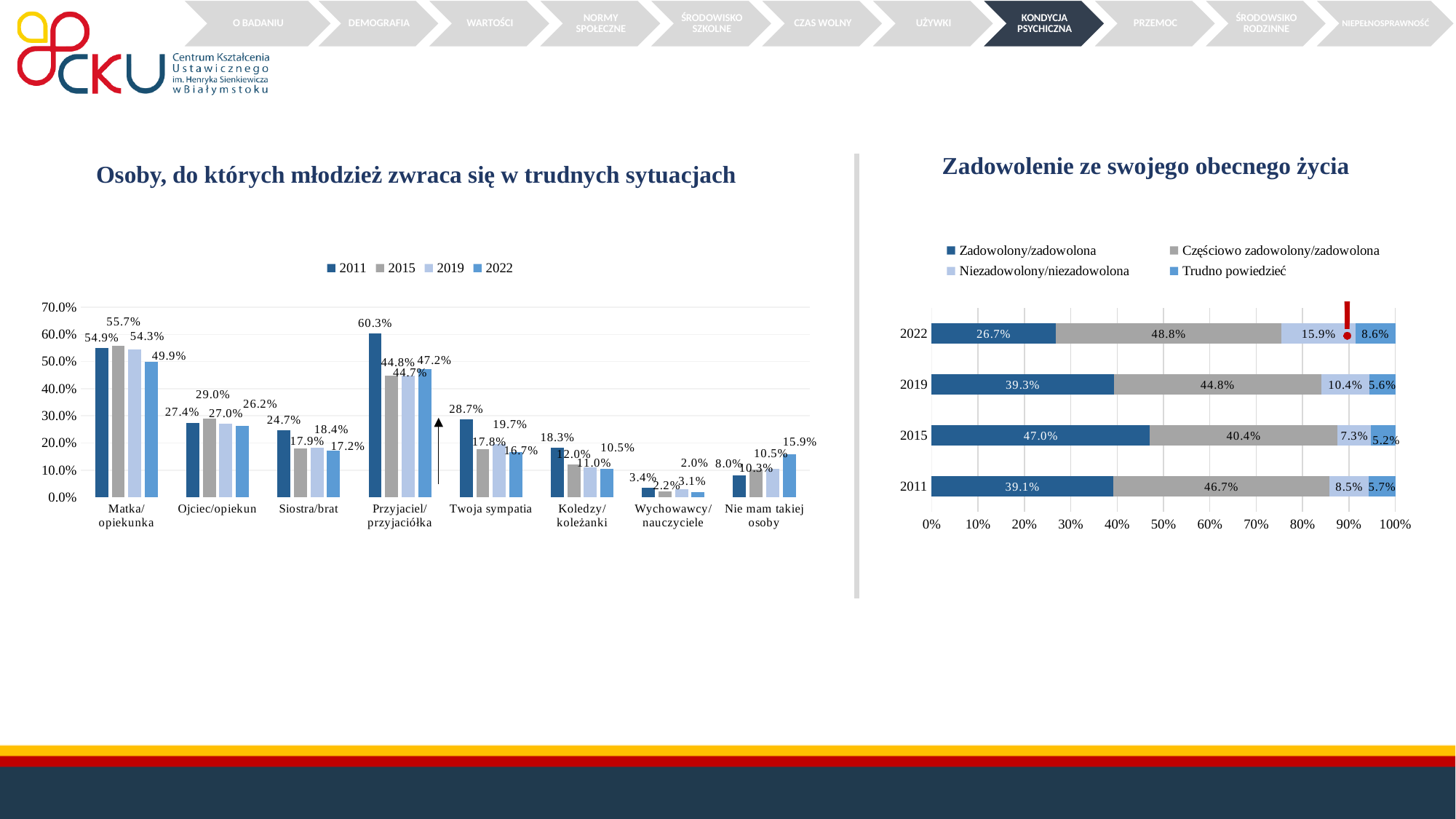
In the chart 'Zadowolenie ze swojego obecnego życia', is the Niezadowolony/niezadowolona value larger in 2022 or in 2019? 2022 In the chart 'Osoby, do których młodzież zwraca się w trudnych sytuacjach', how many categories are shown on the x axis? 8 In the chart 'Zadowolenie ze swojego obecnego życia', what is the share of Zadowolony/zadowolona in 2022? 26.7% In the chart 'Osoby, do których młodzież zwraca się w trudnych sytuacjach', what is the value for Nie mam takiej osoby in 2022? 15.9% In the chart 'Zadowolenie ze swojego obecnego życia', what is the difference between the Częściowo zadowolony/zadowolona values for 2022 and 2015? 8.4% In the chart 'Osoby, do których młodzież zwraca się w trudnych sytuacjach', which category has the lowest value for 2022? Wychowawcy/nauczyciele In the chart 'Osoby, do których młodzież zwraca się w trudnych sytuacjach', how many series does the legend list? 4 In the chart 'Zadowolenie ze swojego obecnego życia', which year has the highest value for Zadowolony/zadowolona? 2015 In the chart 'Osoby, do których młodzież zwraca się w trudnych sytuacjach', what is the value for Przyjaciel/przyjaciółka in 2011? 60.3% What kind of chart is 'Zadowolenie ze swojego obecnego życia'? stacked bar chart In the chart 'Osoby, do których młodzież zwraca się w trudnych sytuacjach', what is the difference between the 2011 and 2022 values for Matka/opiekunka? 5.0% In the chart 'Osoby, do których młodzież zwraca się w trudnych sytuacjach', do the values for Nie mam takiej osoby rise or fall from 2011 to 2022? rise